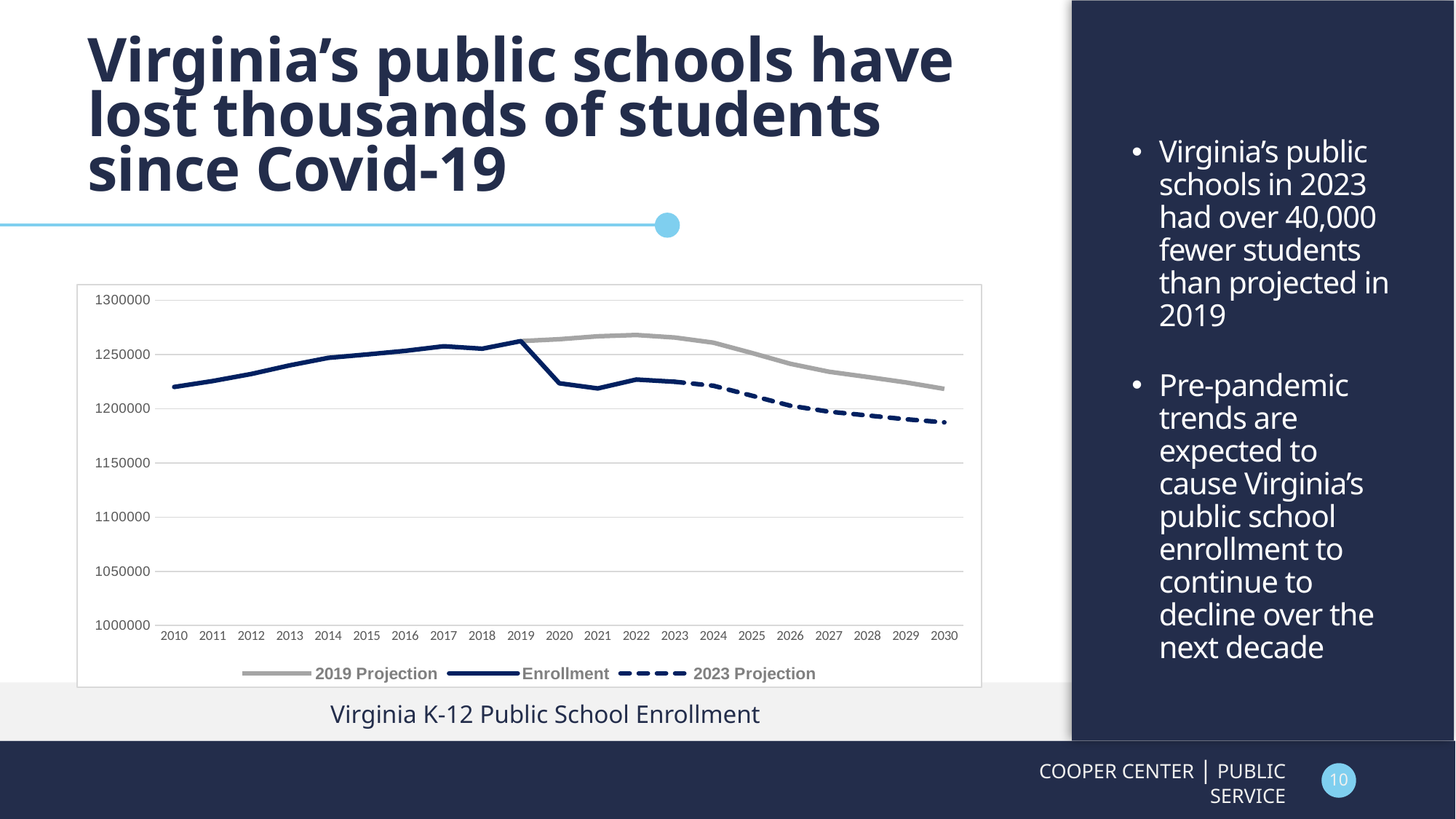
Is the 2019 Projection value for 2022 greater or less than 1250000? greater What kind of chart is shown on the slide? Line chart Is the Enrollment value for 2020 greater or less than 1250000? less What is the caption shown below the chart? Virginia K-12 Public School Enrollment Is the Enrollment value for 2010 greater or less than 1200000? greater In 2030, which series shows the larger value: 2019 Projection or 2023 Projection? 2019 Projection Does the Enrollment line rise or fall between 2010 and 2019? Rise How many years are shown along the x axis of the chart? 21 How many series does the chart legend list? 3 Which year has the highest value on the Enrollment line? 2019 Does the 2023 Projection line rise or fall between 2023 and 2030? Fall